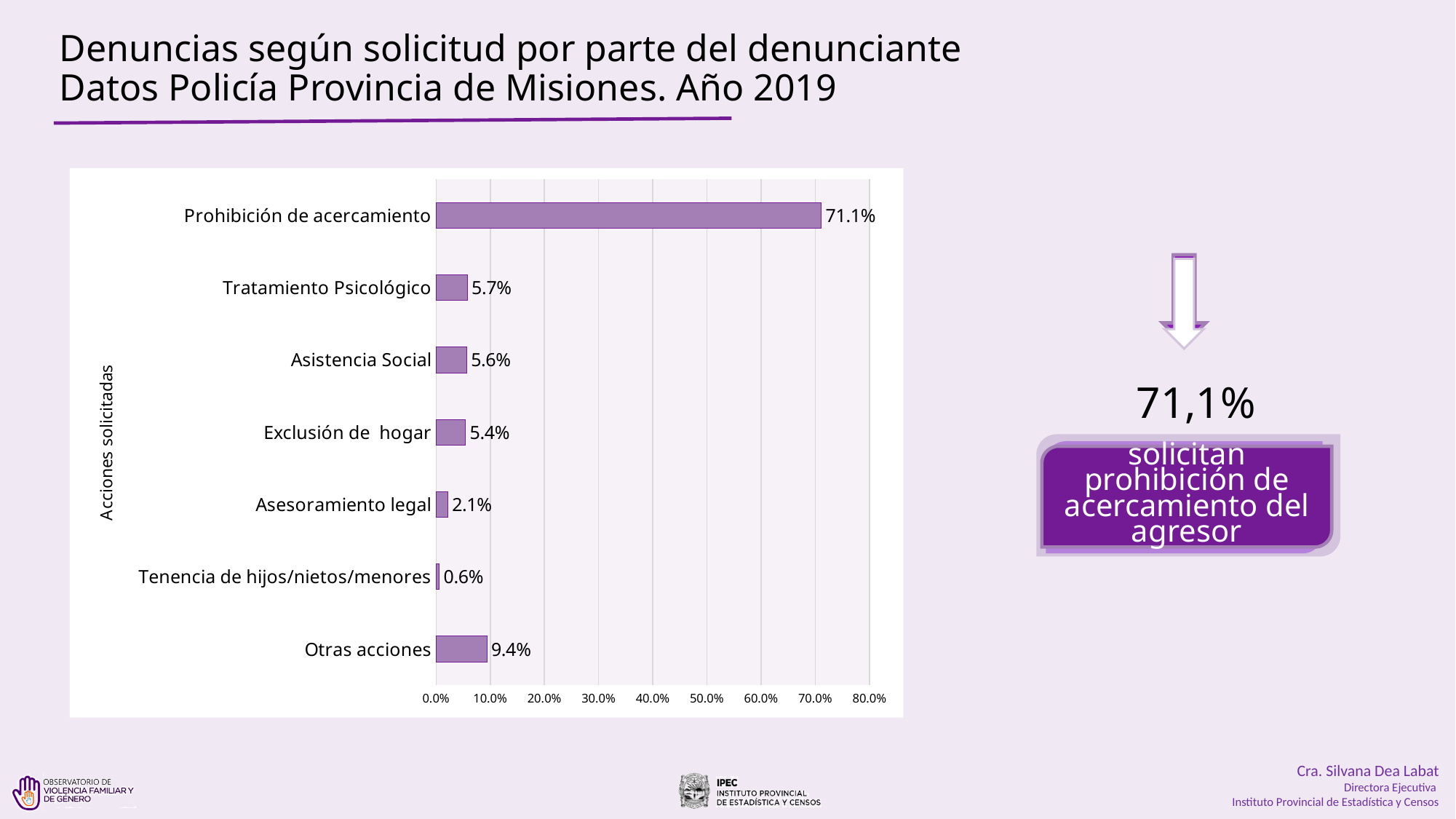
Is the value for Prohibición de acercamiento greater or less than 60.0%? greater Which category has the lowest value? Tenencia de hijos/nietos/menores What is the value for Exclusión de hogar? 5.4% What kind of chart is shown on the slide? Bar chart What is the value for Tratamiento Psicológico? 5.7% Which is larger, the value for Otras acciones or the value for Asesoramiento legal? Otras acciones Which category has the highest value? Prohibición de acercamiento What is the value for Prohibición de acercamiento? 71.1% What is the value for Otras acciones? 9.4% What is the difference between the values for Prohibición de acercamiento and Otras acciones? 61.7% What is the value for Tenencia de hijos/nietos/menores? 0.6% How many categories are shown in the chart? 7